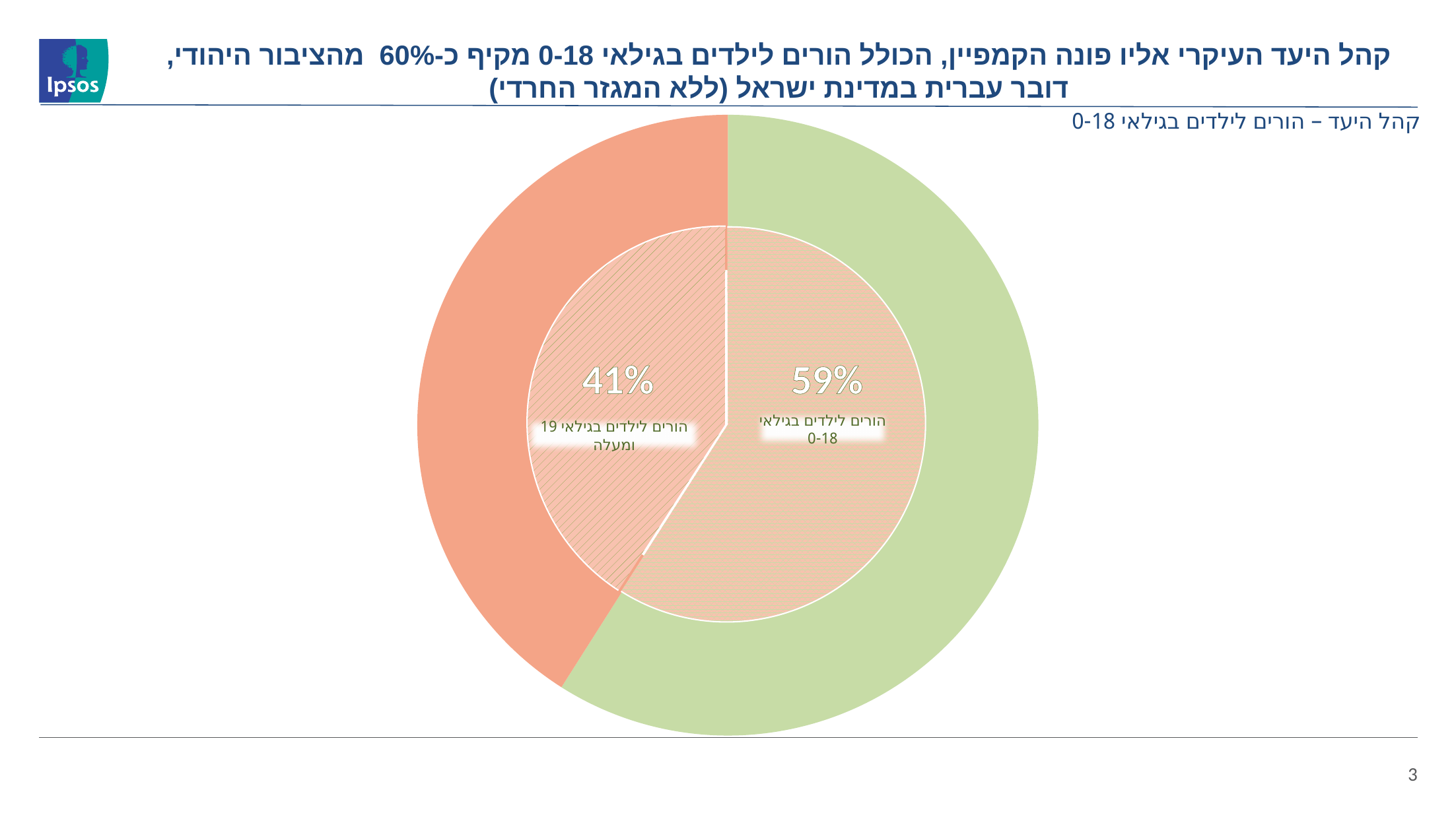
Which slice of the inner pie is drawn with diagonal hatching? The 41% slice (הורים לילדים בגילאי 19 ומעלה) Which slice of the pie chart is the largest? הורים לילדים בגילאי 0-18 Is the value for "הורים לילדים בגילאי 0-18" greater or less than 50%? greater How many labelled slices does the pie chart have? 2 What is the difference in percentage points between the "הורים לילדים בגילאי 0-18" slice and the "הורים לילדים בגילאי 19 ומעלה" slice? 18 percentage points What share of the pie is taken by parents of children aged 19 and over (הורים לילדים בגילאי 19 ומעלה)? 41% What kind of chart is shown on the slide? Pie chart What percentage does the slice labelled "הורים לילדים בגילאי 0-18" (parents of children aged 0-18) show? 59% What do the two labelled slices of the pie chart add up to? 100% Which slice of the pie chart is the smallest? הורים לילדים בגילאי 19 ומעלה Which is larger: the share for parents of children aged 0-18 or the share for parents of children aged 19 and over? Parents of children aged 0-18 (הורים לילדים בגילאי 0-18) What percentage does the slice labelled "הורים לילדים בגילאי 19 ומעלה" (parents of children aged 19 and over) show? 41%